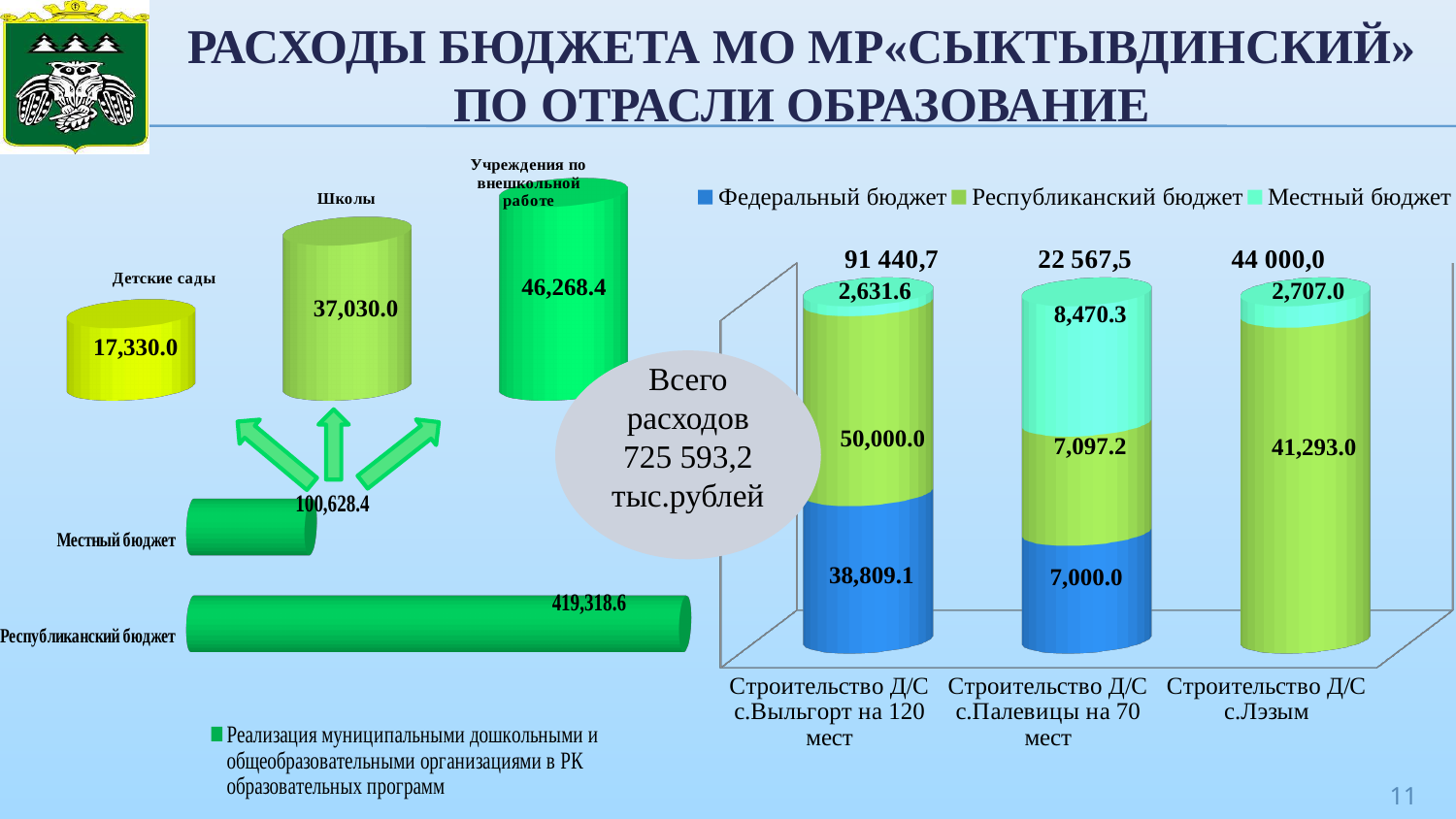
In the horizontal bar chart at the bottom left, what is the value for Республиканский бюджет? 419,318.6 In the stacked bar chart on the right, what is the Республиканский бюджет value for Строительство Д/С с.Лэзым? 41,293.0 In the stacked bar chart on the right, what is the Местный бюджет value for Строительство Д/С с.Палевицы на 70 мест? 8,470.3 In the cylinder chart at the top left, what is the value for Школы? 37,030.0 In the stacked bar chart on the right, what is the Федеральный бюджет value for Строительство Д/С с.Выльгорт на 120 мест? 38,809.1 In the horizontal bar chart at the bottom left, which is larger: Местный бюджет or Республиканский бюджет? Республиканский бюджет In the stacked bar chart on the right, what is the total shown above the bar for Строительство Д/С с.Выльгорт на 120 мест? 91 440,7 In the stacked bar chart on the right, what is the difference between the Республиканский бюджет values for Строительство Д/С с.Выльгорт на 120 мест and Строительство Д/С с.Лэзым? 8,707.0 In the cylinder chart at the top left, how many categories are shown? 3 In the stacked bar chart on the right, how many series does the legend list? 3 In the cylinder chart at the top left, which category has the highest value? Учреждения по внешкольной работе In the stacked bar chart on the right, which category has the lowest total? Строительство Д/С с.Палевицы на 70 мест